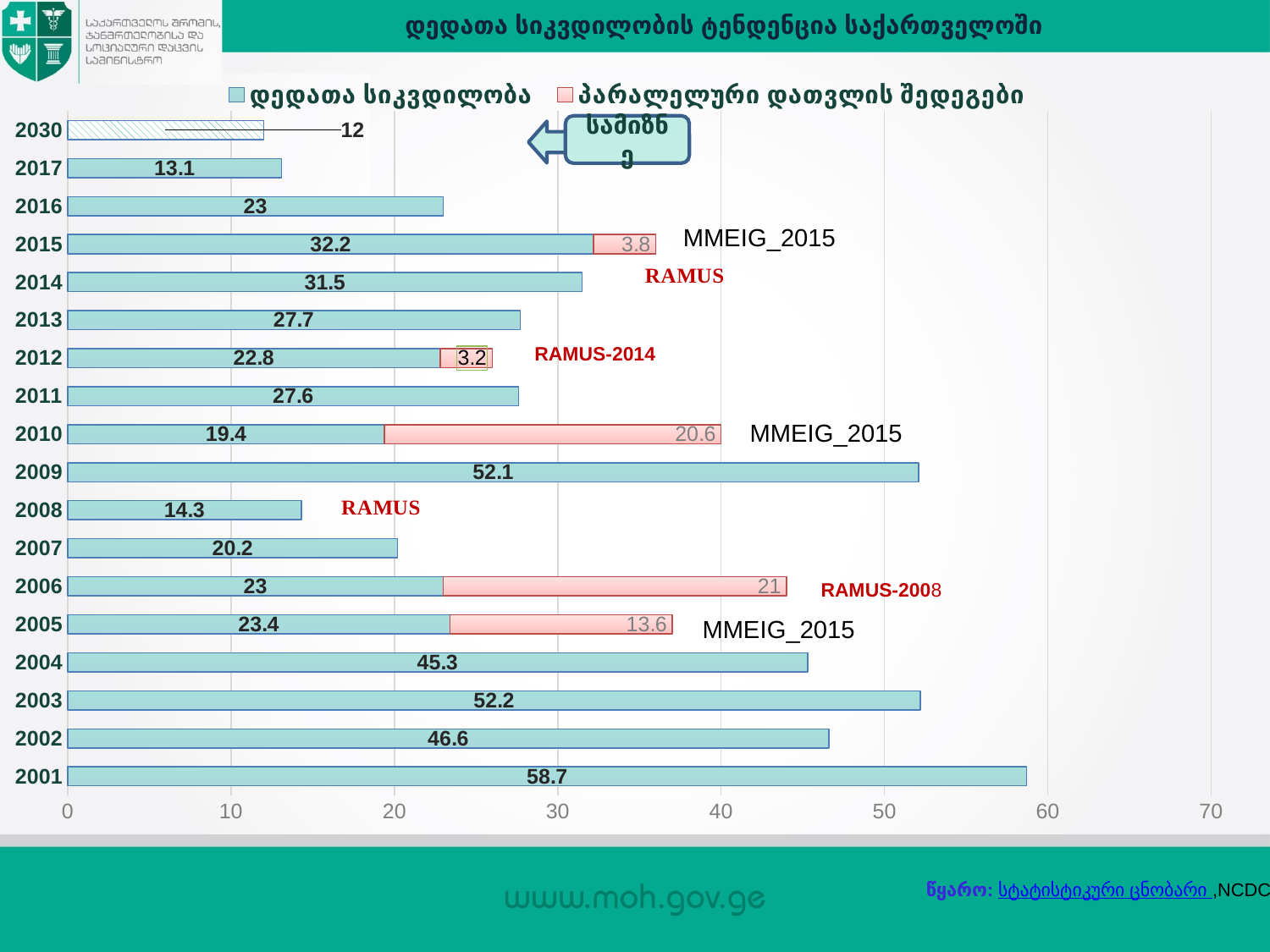
Overall, do the maternal mortality (teal bar) values rise or fall from 2001 to 2017? fall What is the total of the stacked bar for 2006? 44 How many series does the legend list? 2 What is the difference between the maternal mortality values for 2001 and 2017? 45.6 What is the maternal mortality (teal bar) value for 2001? 58.7 How many year categories are shown on the vertical axis? 18 Which year has the larger maternal mortality (teal bar) value, 2009 or 2008? 2009 Which year has the highest maternal mortality (teal bar) value? 2001 What is the value of the pink parallel-count segment for 2010? 20.6 What is the value shown for 2030? 12 What kind of chart is shown on the slide? bar chart Among the years 2001 to 2017, which year has the lowest maternal mortality (teal bar) value? 2017